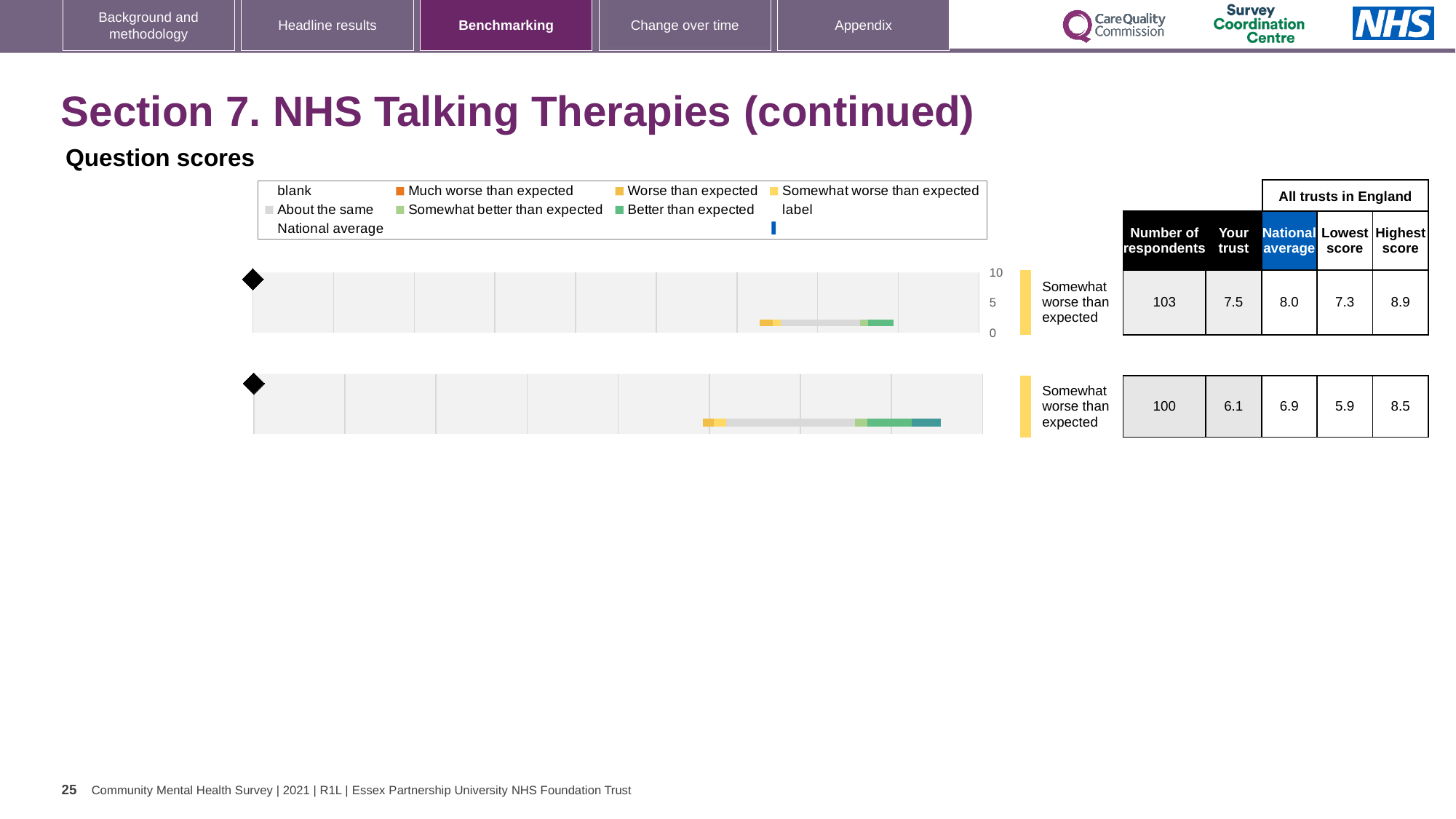
For the first (top) chart row, what is the 'Your trust' score? 7.5 For the second (bottom) chart row, what is the lowest score among all trusts in England? 5.9 For the second (bottom) chart row, what is the difference between the highest score and the lowest score? 2.6 For the second (bottom) chart row, how many respondents are there? 100 For the first (top) chart row, what is the national average score? 8.0 In the legend, which colour represents 'Much worse than expected'? orange How many question score charts (rows) are shown on the slide? 2 Which chart row has the higher 'Your trust' score, the first or the second? the first What kind of chart is used to show the question scores on this slide? bar chart For the first (top) chart row, what is the difference between the national average and the 'Your trust' score? 0.5 For the second (bottom) chart row, which is larger: the 'Your trust' score or the national average? National average